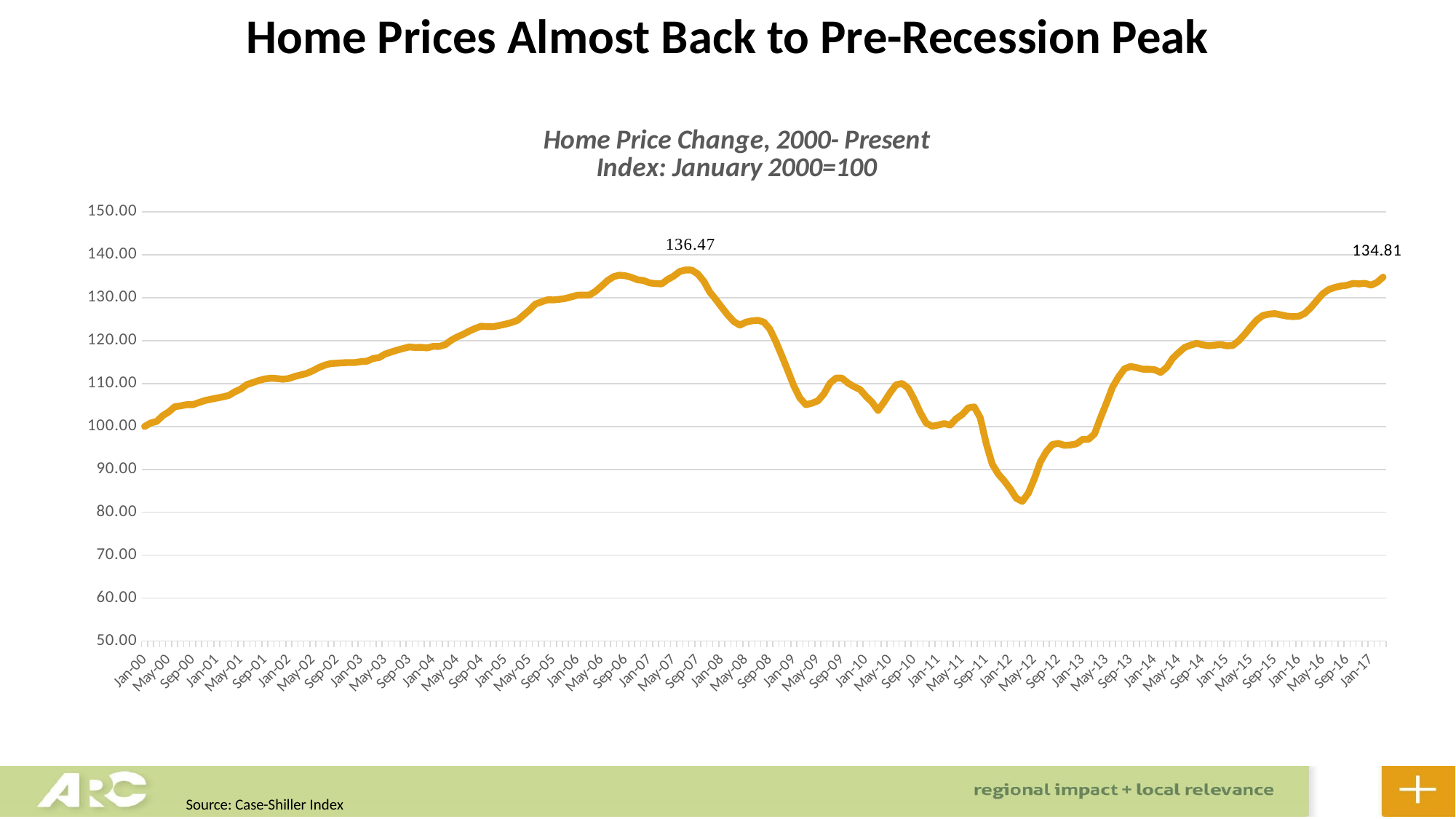
What is the source cited for the chart data? Case-Shiller Index In which year does the line reach its lowest point? 2012 Is the lowest point of the line, in early 2012, greater or less than 90? less What is the value of the data label at the right end of the line (most recent point)? 134.81 Does the line rise or fall between Sep-07 and Jan-12? Fall What is the index value for January 2000, according to the chart subtitle? 100 Which is larger, the pre-recession peak value or the most recent labeled value? The pre-recession peak value (136.47) What kind of chart is shown on the slide? Line chart What is the difference between the pre-recession peak value (136.47) and the most recent labeled value (134.81)? 1.66 Is the value for Sep-06 greater or less than 130? greater What is the value of the data label at the pre-recession peak of the line? 136.47